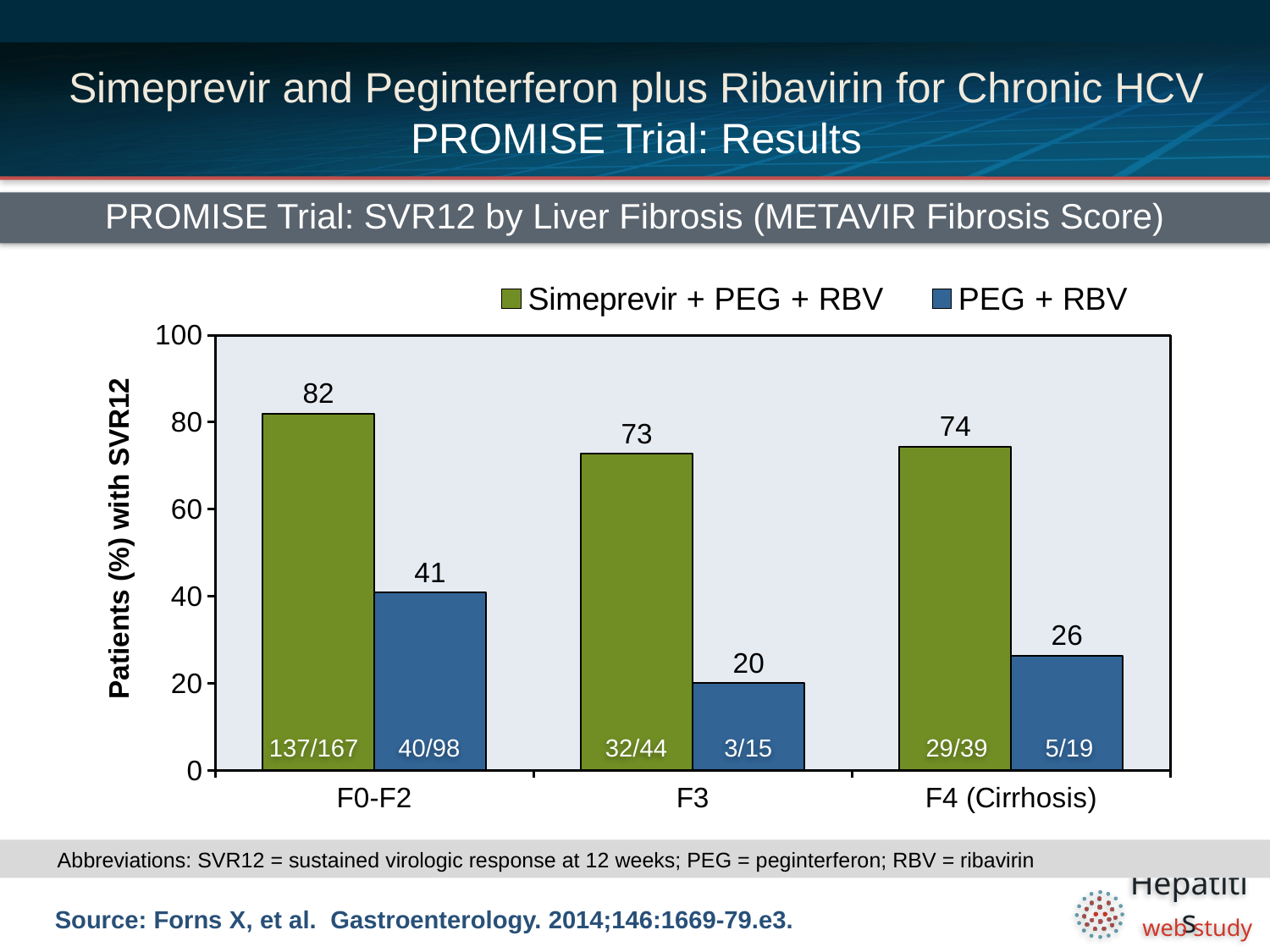
What kind of chart is shown on the slide? Bar chart What is the patient fraction shown inside the Simeprevir + PEG + RBV bar for the F3 group? 32/44 What is the label of the y axis? Patients (%) with SVR12 What is the difference between the Simeprevir + PEG + RBV and PEG + RBV SVR12 rates in the F4 (Cirrhosis) group? 48 How many fibrosis groups are shown on the x axis? 3 What is the SVR12 rate for PEG + RBV in the F3 group? 20 Which fibrosis group has the highest SVR12 rate for Simeprevir + PEG + RBV? F0-F2 What is the SVR12 rate for PEG + RBV in the F4 (Cirrhosis) group? 26 Which fibrosis group has the lowest SVR12 rate for PEG + RBV? F3 In the F0-F2 group, which treatment has the higher SVR12 rate? Simeprevir + PEG + RBV What is the SVR12 rate for Simeprevir + PEG + RBV in the F0-F2 group? 82 How many series does the legend list? 2